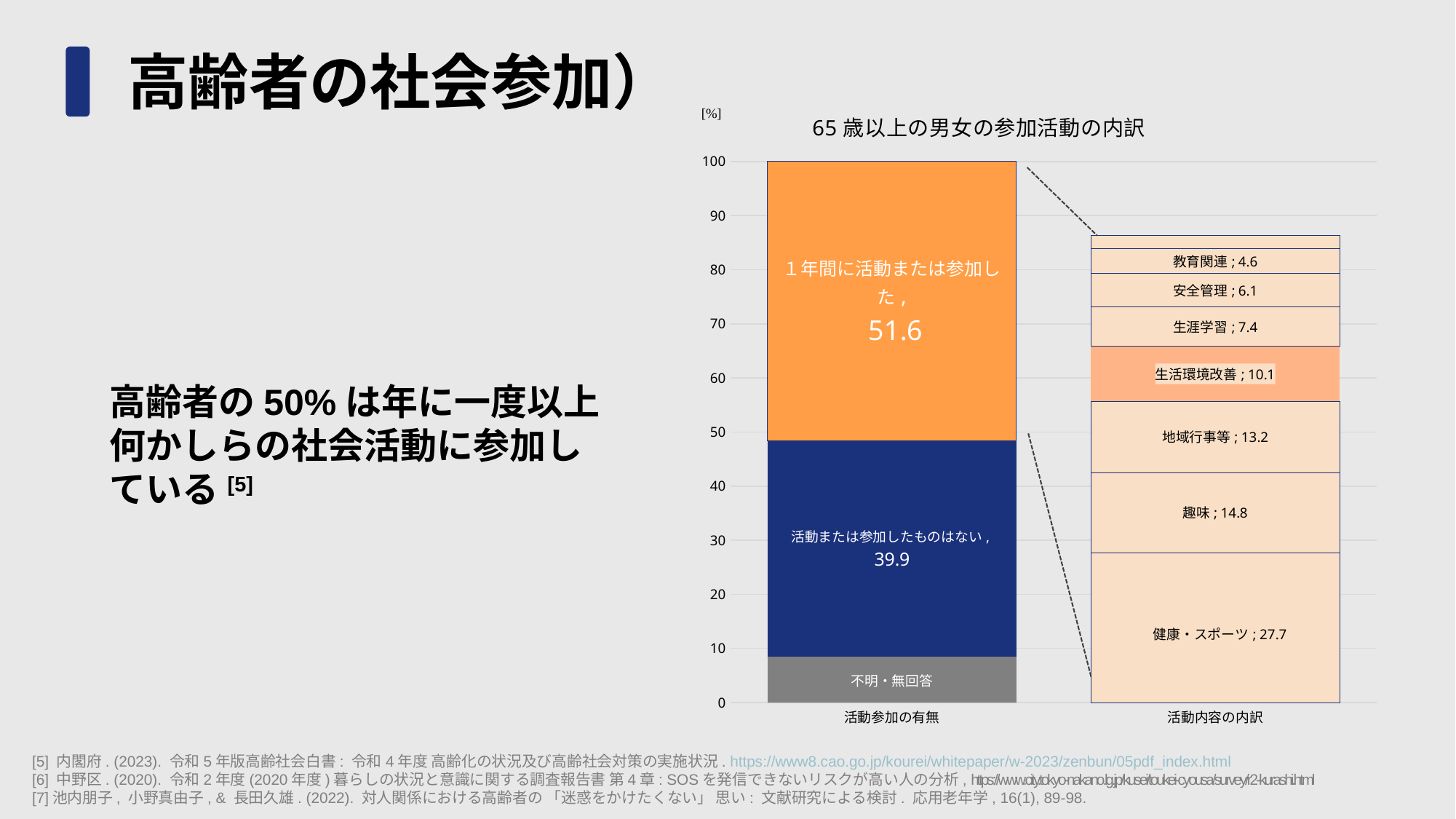
What kind of chart is shown on the slide? Stacked bar chart What is the value for 健康・スポーツ in the 活動内容の内訳 bar? 27.7 Is the value for 不明・無回答 greater or less than 10? less What is the value for 「1年間に活動または参加した」 in the 活動参加の有無 bar? 51.6 Which is larger in the 活動内容の内訳 bar: 趣味 or 地域行事等? 趣味 Which activity category in the 活動内容の内訳 bar has the highest value? 健康・スポーツ What is the value for 「活動または参加したものはない」 in the 活動参加の有無 bar? 39.9 What is the value for 生活環境改善 in the 活動内容の内訳 bar? 10.1 How many activity categories with printed values are shown in the 活動内容の内訳 bar? 7 Which activity category in the 活動内容の内訳 bar has the lowest printed value? 教育関連 What is the difference between 「1年間に活動または参加した」 (51.6) and 「活動または参加したものはない」 (39.9)? 11.7 What is the title of the chart? 65歳以上の男女の参加活動の内訳